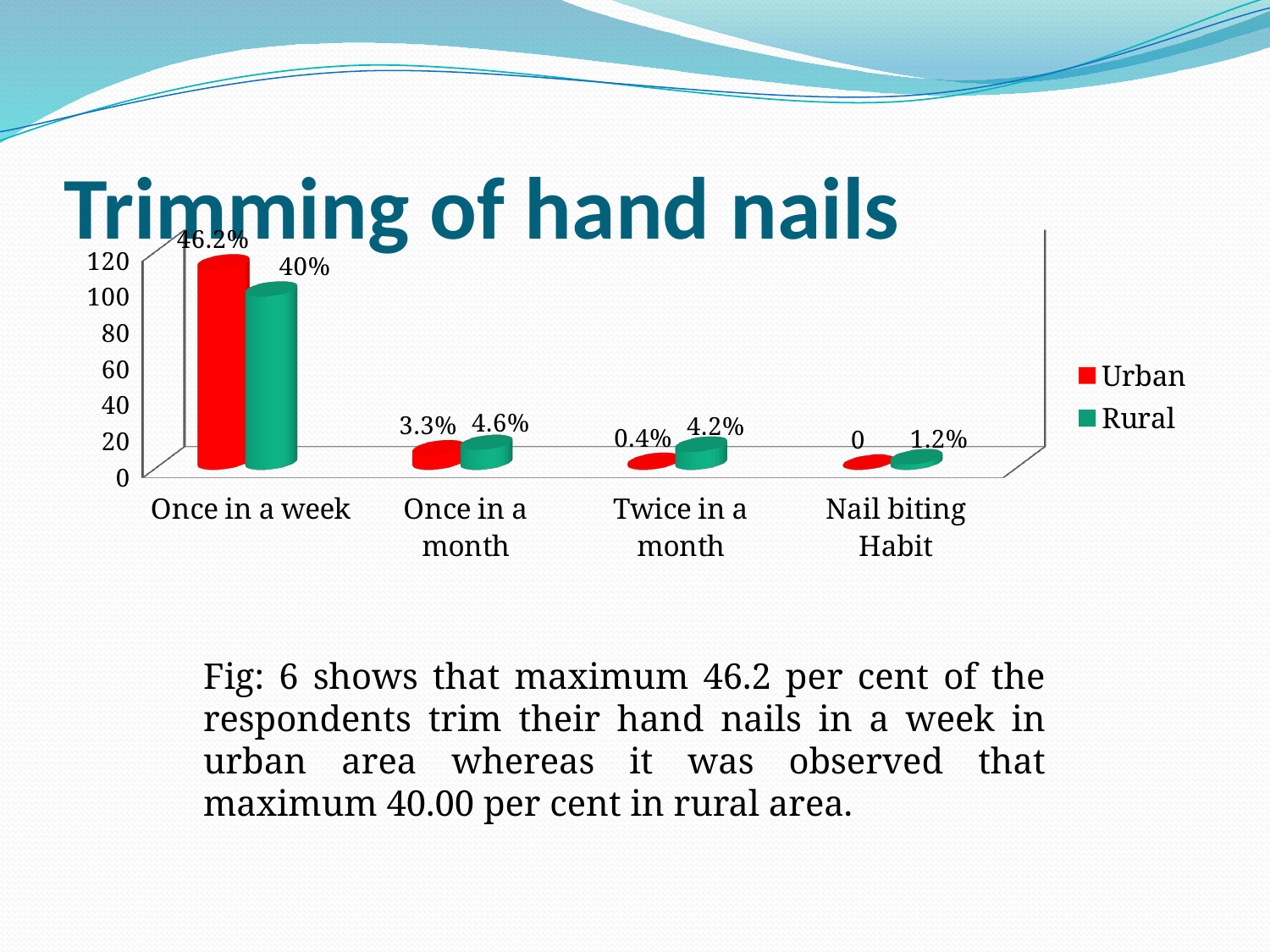
Which category has the lowest Rural value? Nail biting Habit What is the Urban value for Once in a month? 3.3% How many categories are shown on the x axis? 4 What is the difference between the Urban and Rural values for Once in a week? 6.2 percentage points What kind of chart is shown on the slide? Bar chart What is the Rural value for Once in a week? 40% What is the Urban value for Once in a week? 46.2% What is the Rural value for Twice in a month? 4.2% What is the Urban value for Nail biting Habit? 0 For Twice in a month, which is larger, the Urban value or the Rural value? Rural Which category has the highest Urban value? Once in a week How many series does the legend list? 2